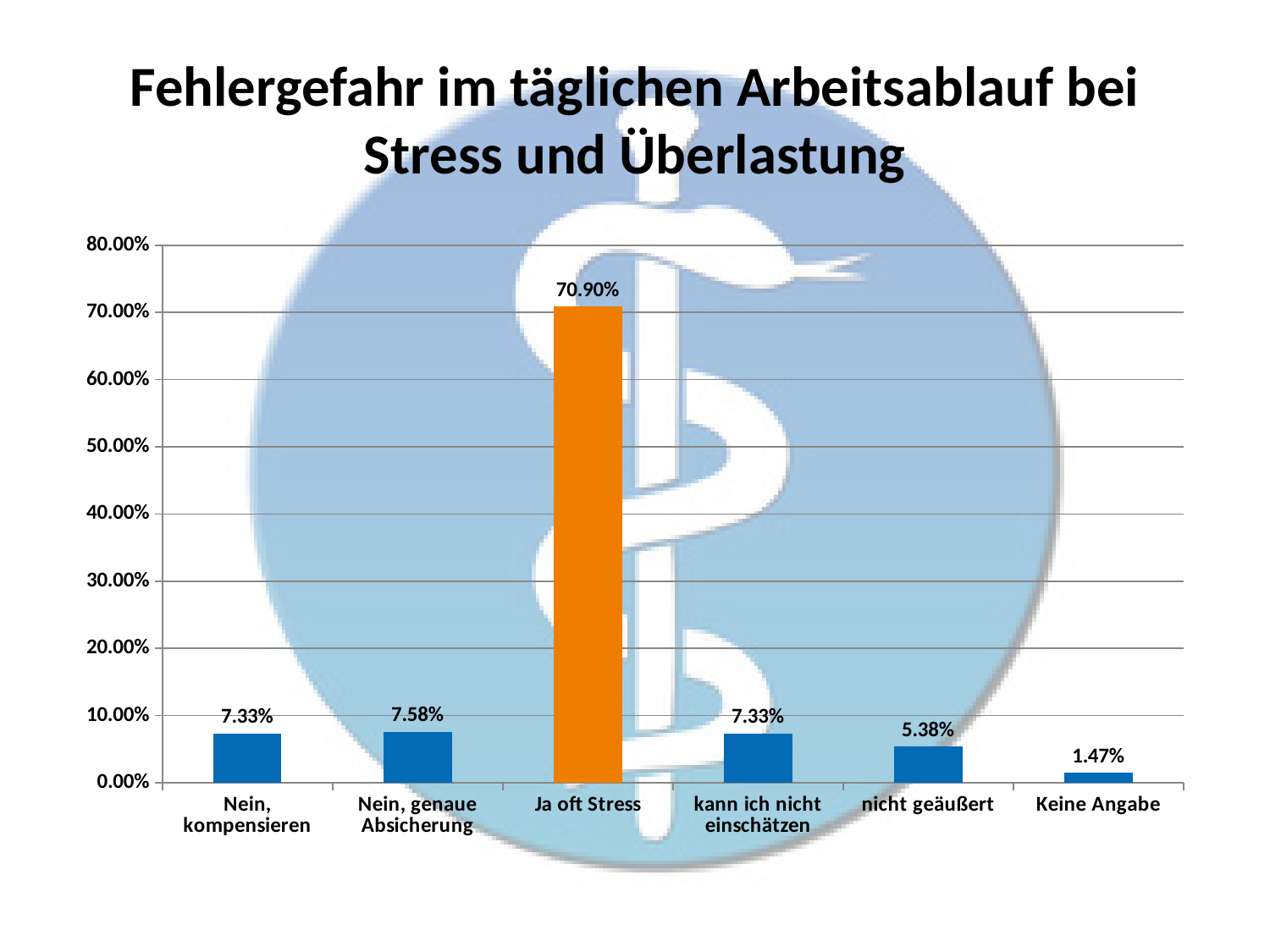
What is the value for "nicht geäußert"? 5.38% Is the value for "Ja oft Stress" greater or less than 60.00%? greater How many categories are shown on the x axis? 6 What is the value for "Ja oft Stress"? 70.90% What is the value for "Keine Angabe"? 1.47% Which is larger, the value for "nicht geäußert" or the value for "Keine Angabe"? nicht geäußert What is the value for "Nein, genaue Absicherung"? 7.58% Which category has the highest value? Ja oft Stress What kind of chart is shown on the slide? Bar chart What is the difference between the values for "Ja oft Stress" and "Nein, genaue Absicherung"? 63.32% Which category has the lowest value? Keine Angabe Which bar is coloured orange rather than blue? Ja oft Stress